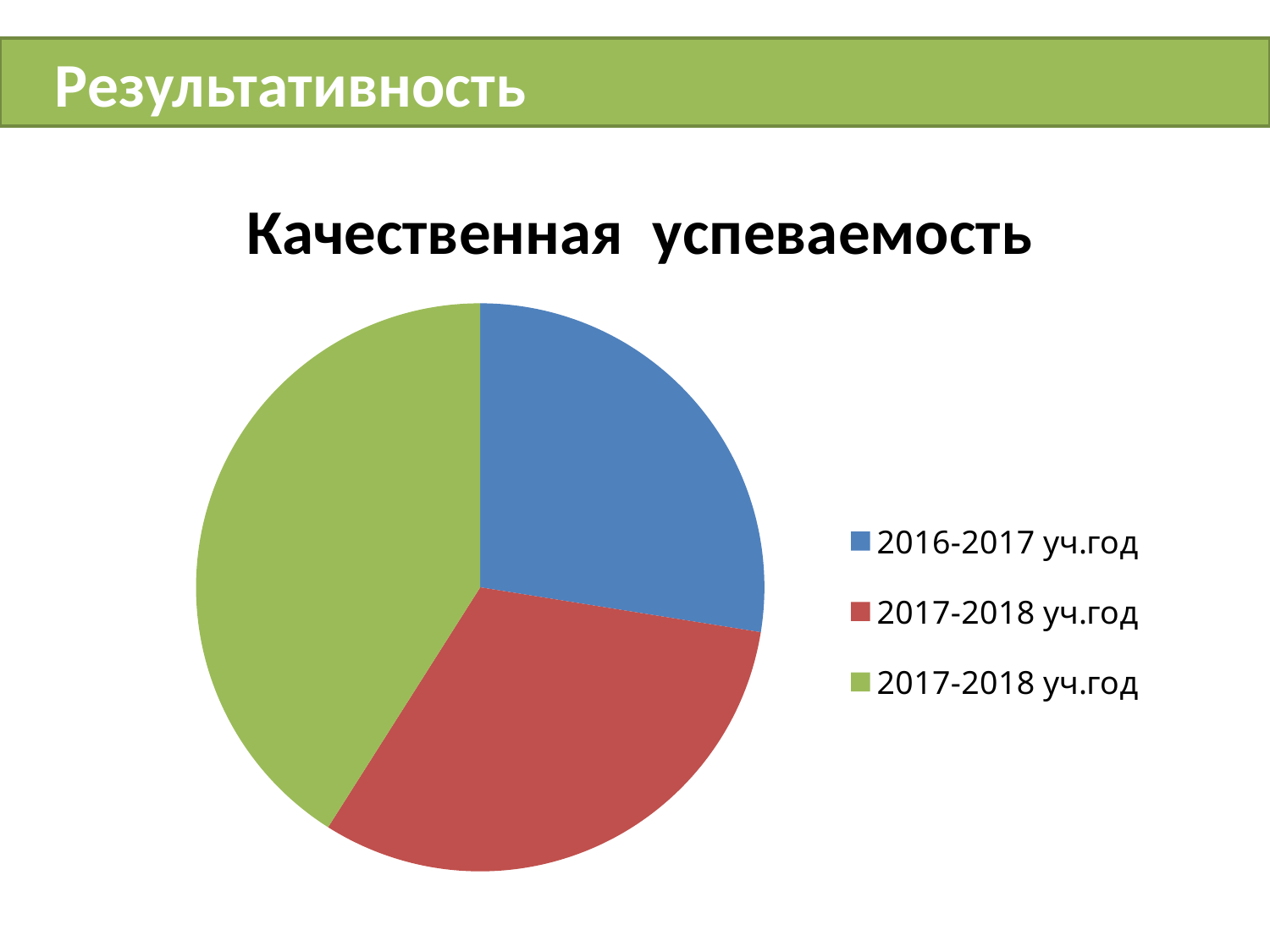
What is the title of the chart? Качественная успеваемость Which slice of the pie chart is the largest? the green slice (2017-2018 уч.год) How many entries does the legend list? 3 Is the green slice larger or smaller than the red slice? larger What kind of chart is shown on the slide? pie chart Does the pie chart display any data labels with values? No Which legend entry is shown in blue? 2016-2017 уч.год Is the green slice larger or smaller than the blue slice? larger How many slices does the pie chart have? 3